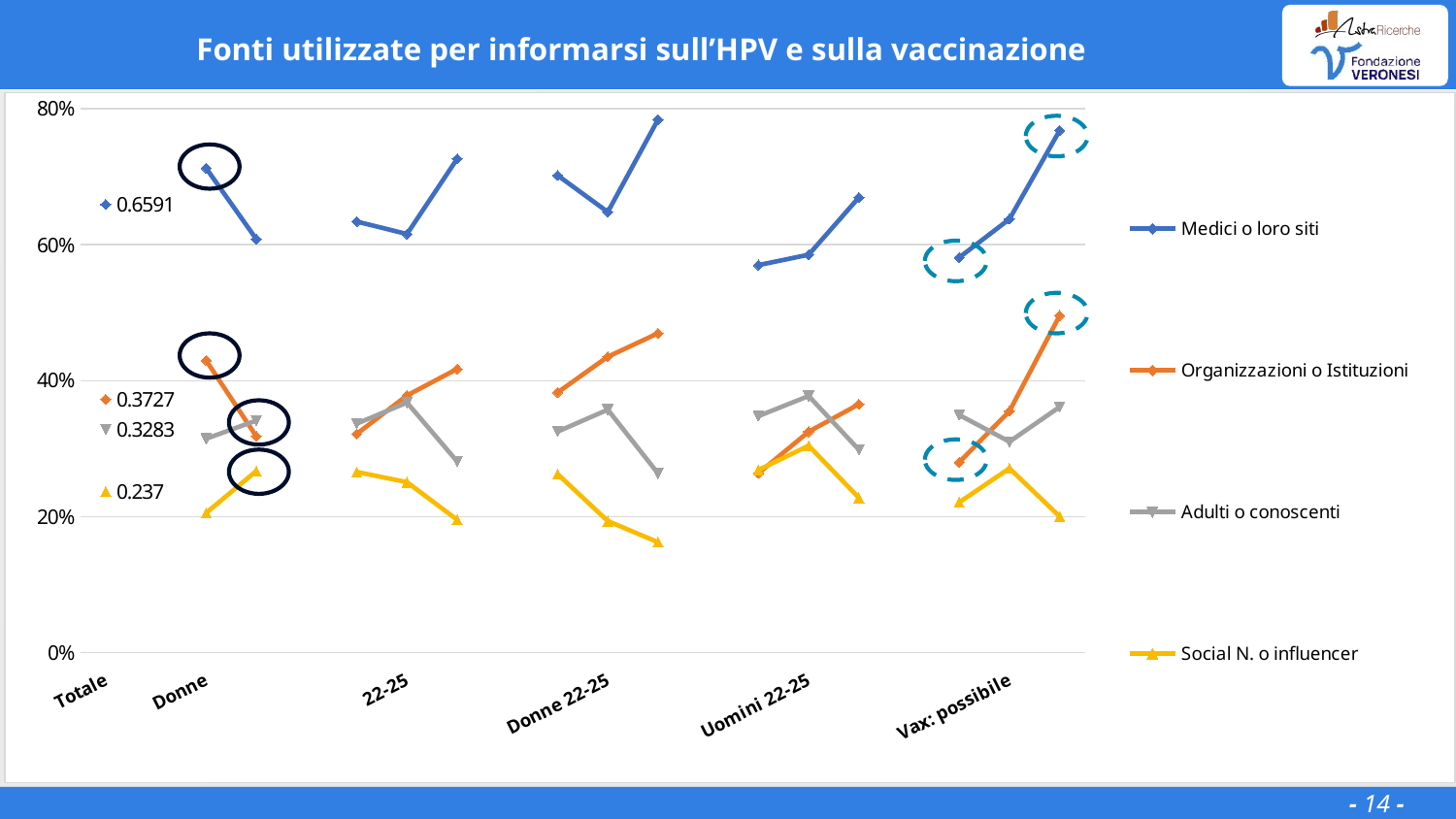
What is the value for Adulti o conoscenti at Totale? 0.3283 What is the difference between Medici o loro siti and Organizzazioni o Istituzioni at Totale? 0.2864 Which series has the highest value at Totale? Medici o loro siti At Totale, which is larger: Organizzazioni o Istituzioni or Adulti o conoscenti? Organizzazioni o Istituzioni Which series has the lowest value at Totale? Social N. o influencer What is the value for Organizzazioni o Istituzioni at Totale? 0.3727 What is the value for Medici o loro siti at Totale? 0.6591 What is the title of the chart? Fonti utilizzate per informarsi sull'HPV e sulla vaccinazione Is the value for Medici o loro siti at Totale greater or less than 60%? greater What kind of chart is shown on the slide? Line chart How many series does the legend list? 4 What is the value for Social N. o influencer at Totale? 0.237